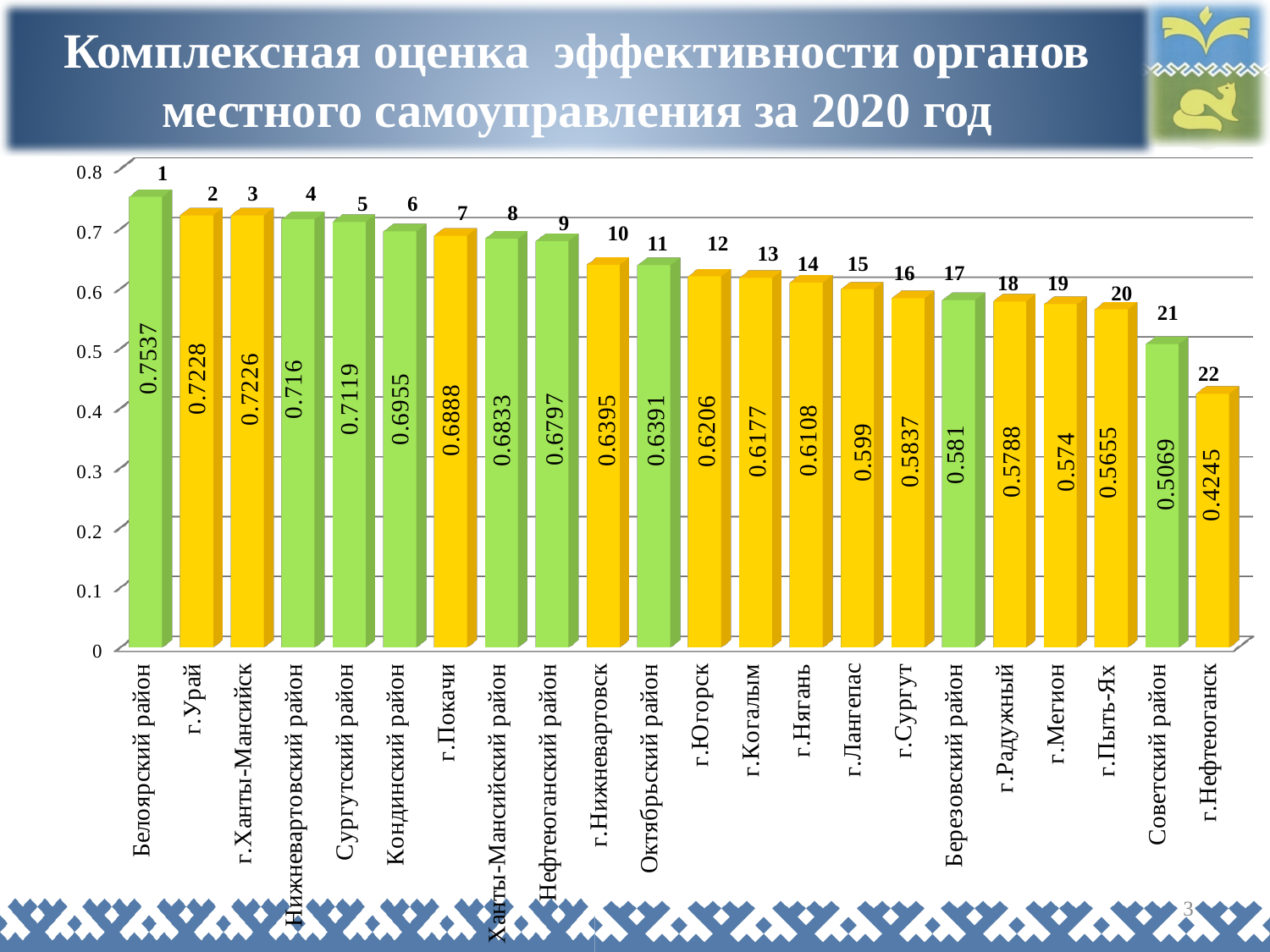
Which category has the lowest value? г.Нефтеюганск Which is larger, the value for г.Сургут or the value for г.Мегион? г.Сургут What kind of chart is shown on the slide? bar chart What is the difference between the values for Белоярский район and г.Урай? 0.0309 Is the value for г.Лангепас greater or less than 0.6? less What is the difference between the values for Белоярский район and г.Нефтеюганск? 0.3292 What is the value for г.Покачи? 0.6888 How many categories are shown on the x axis? 22 What is the value for Советский район? 0.5069 What is the value for г.Когалым? 0.6177 Which category has the highest value? Белоярский район Do the values rise or fall from left to right along the x axis? fall